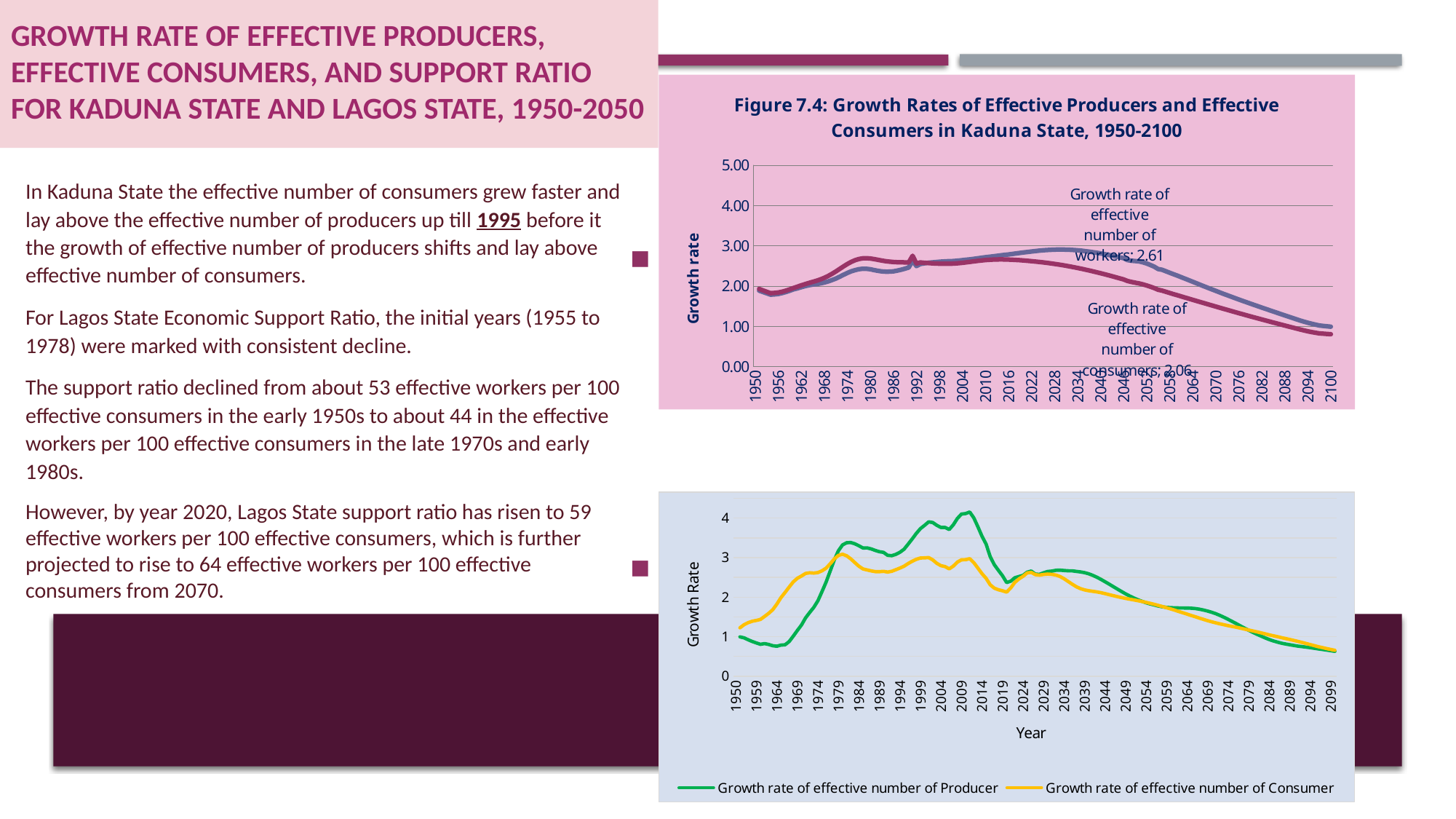
In the bottom chart, does the growth rate of effective number of Producer rise or fall from 2034 to 2099? fall In the top chart (Figure 7.4), is the growth rate of effective number of workers in 2028 greater or less than 2.00? greater How many series does the legend of the bottom chart list? 2 In the bottom chart, is the growth rate of effective number of Producer in 1964 greater or less than 1? less In the bottom chart, which series reaches the higher peak value? Growth rate of effective number of Producer In the top chart (Figure 7.4), what value is printed in the data label for the growth rate of effective number of workers? 2.61 In the top chart (Figure 7.4), is the growth rate of effective number of workers in 2100 greater or less than 2.00? less What is the title of the top chart? Figure 7.4: Growth Rates of Effective Producers and Effective Consumers in Kaduna State, 1950-2100 In the top chart (Figure 7.4), what value is printed in the data label for the growth rate of effective number of consumers? 2.06 What kind of chart is the top chart, Figure 7.4? line chart In the top chart (Figure 7.4), what is the difference between the labelled values for workers (2.61) and consumers (2.06)? 0.55 In the top chart (Figure 7.4), which labelled value is larger: the growth rate of effective number of workers or of consumers? Growth rate of effective number of workers